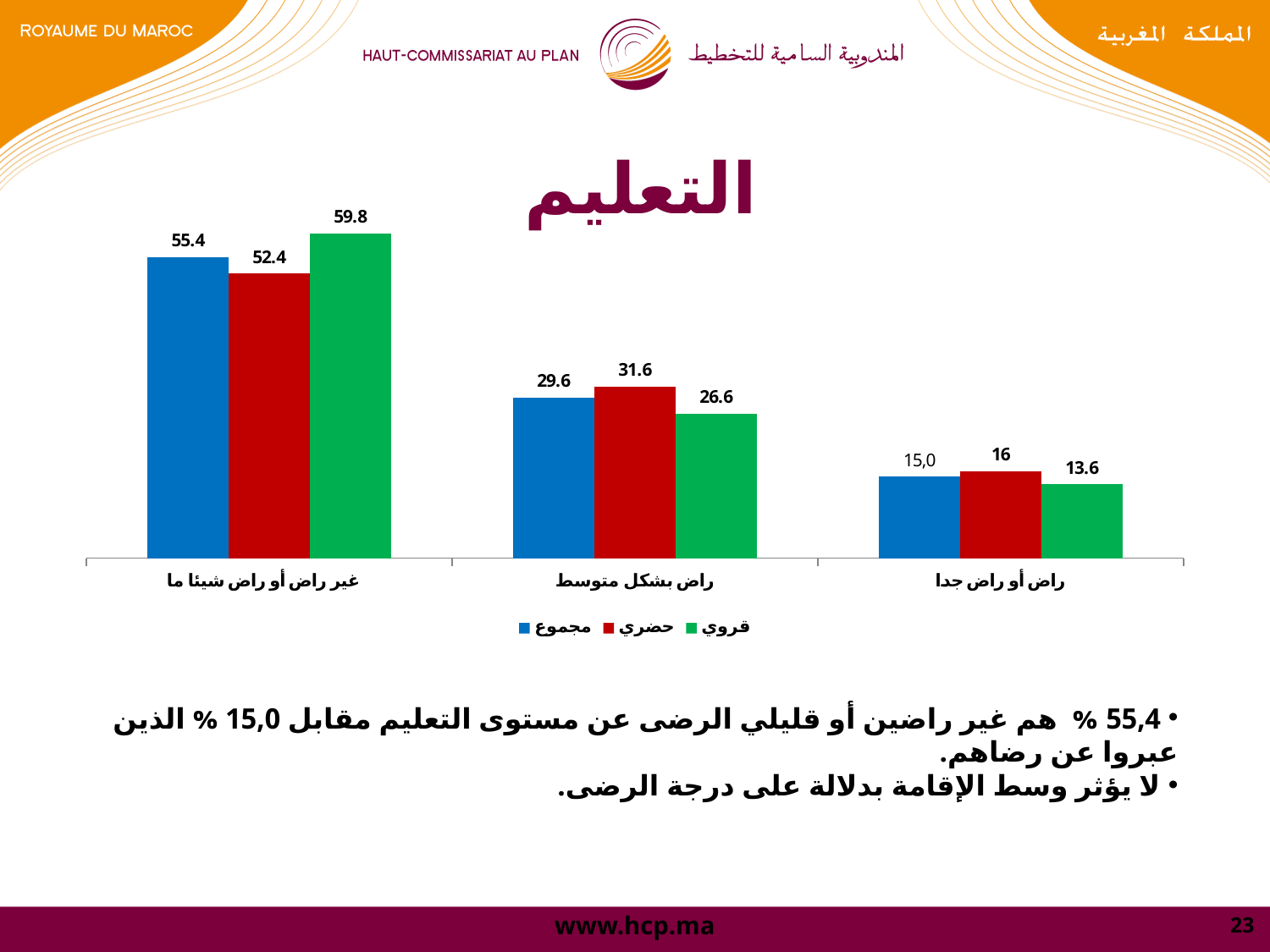
What is the value for حضري in the category راض بشكل متوسط? 31.6 What is the title of the chart? التعليم How many categories are shown on the x axis? 3 What type of chart is shown on the slide? bar chart What is the value for قروي in the category غير راض أو راض شيئا ما? 59.8 Which category has the lowest value for the قروي series? راض أو راض جدا What is the difference between the قروي and حضري values in the category غير راض أو راض شيئا ما? 7.4 How many series does the legend list? 3 In the category راض بشكل متوسط, which is larger: the value for حضري or the value for قروي? حضري What is the value for مجموع in the category راض أو راض جدا? 15,0 Which colour represents the حضري series? red Which category has the highest value for the مجموع series? غير راض أو راض شيئا ما